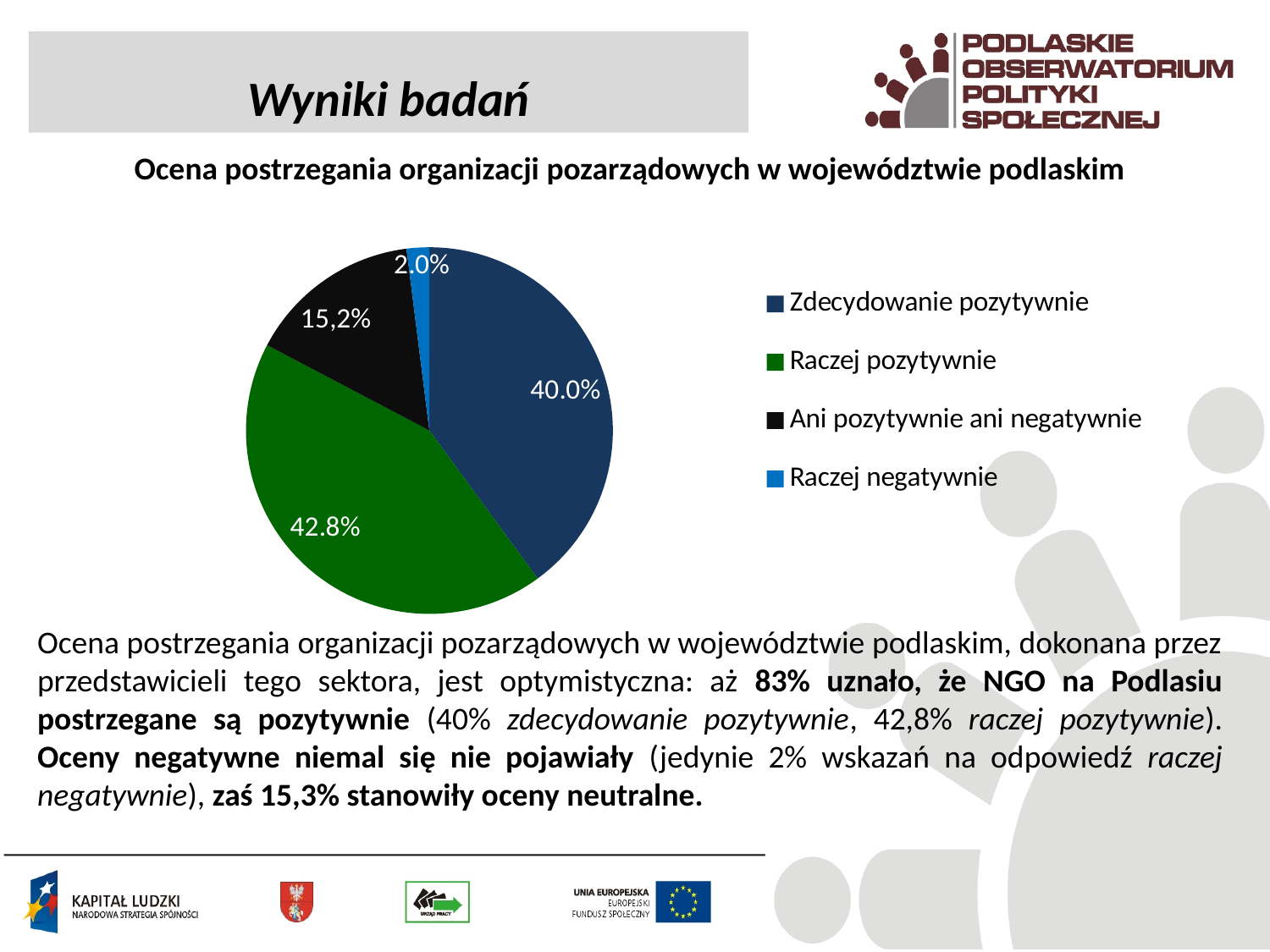
What percentage of the pie chart is labelled for "Raczej pozytywnie"? 42.8% What percentage of the pie chart is labelled for "Zdecydowanie pozytywnie"? 40.0% What colour is the "Raczej pozytywnie" slice in the pie chart? Green What type of chart is shown on the slide? Pie chart Which category has the largest slice of the pie chart? Raczej pozytywnie Which category has the smallest slice of the pie chart? Raczej negatywnie What percentage of the pie chart is labelled for "Raczej negatywnie"? 2.0% How many slices does the pie chart have? 4 How many entries does the chart legend list? 4 What is the difference in percentage points between the "Raczej pozytywnie" slice and the "Zdecydowanie pozytywnie" slice? 2.8 What percentage of the pie chart is labelled for "Ani pozytywnie ani negatywnie"? 15,2% Which slice is larger: "Zdecydowanie pozytywnie" or "Ani pozytywnie ani negatywnie"? Zdecydowanie pozytywnie